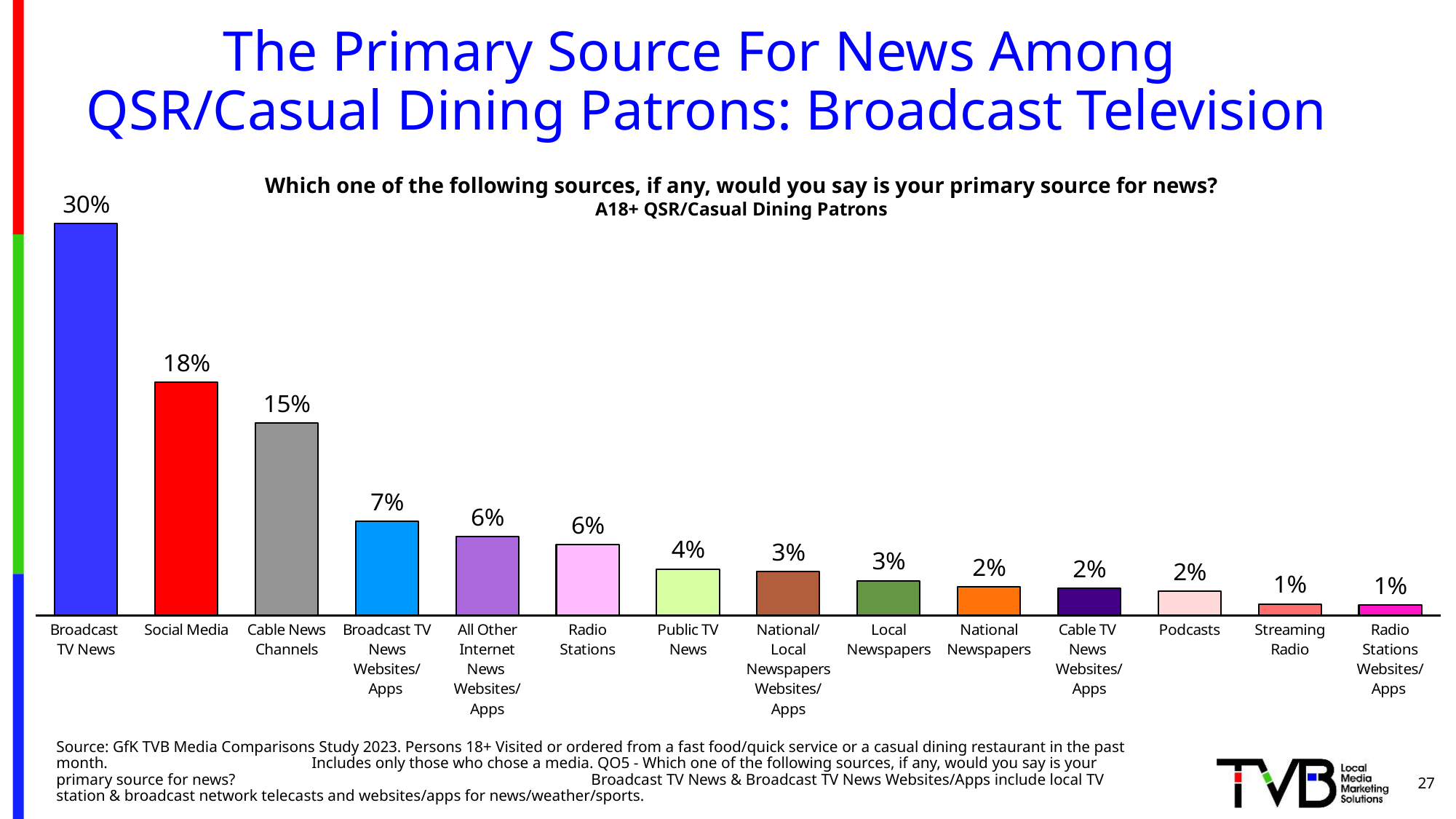
What is the value shown for Public TV News? 4% What kind of chart is shown on the slide? Bar chart What percentage of QSR/Casual Dining Patrons say Broadcast TV News is their primary source for news? 30% What is the difference between the values for Broadcast TV News and Social Media? 12% What is the difference between the values for Cable News Channels and Broadcast TV News Websites/Apps? 8% Which is larger, the value for Social Media or the value for Cable News Channels? Social Media Which news source has the highest value on the chart? Broadcast TV News What is the value shown for Cable News Channels? 15% What is the value shown for Social Media? 18% Do the values rise or fall moving from left to right across the chart? Fall Which is larger, the value for Public TV News or the value for National Newspapers? Public TV News How many news source categories are shown on the chart? 14